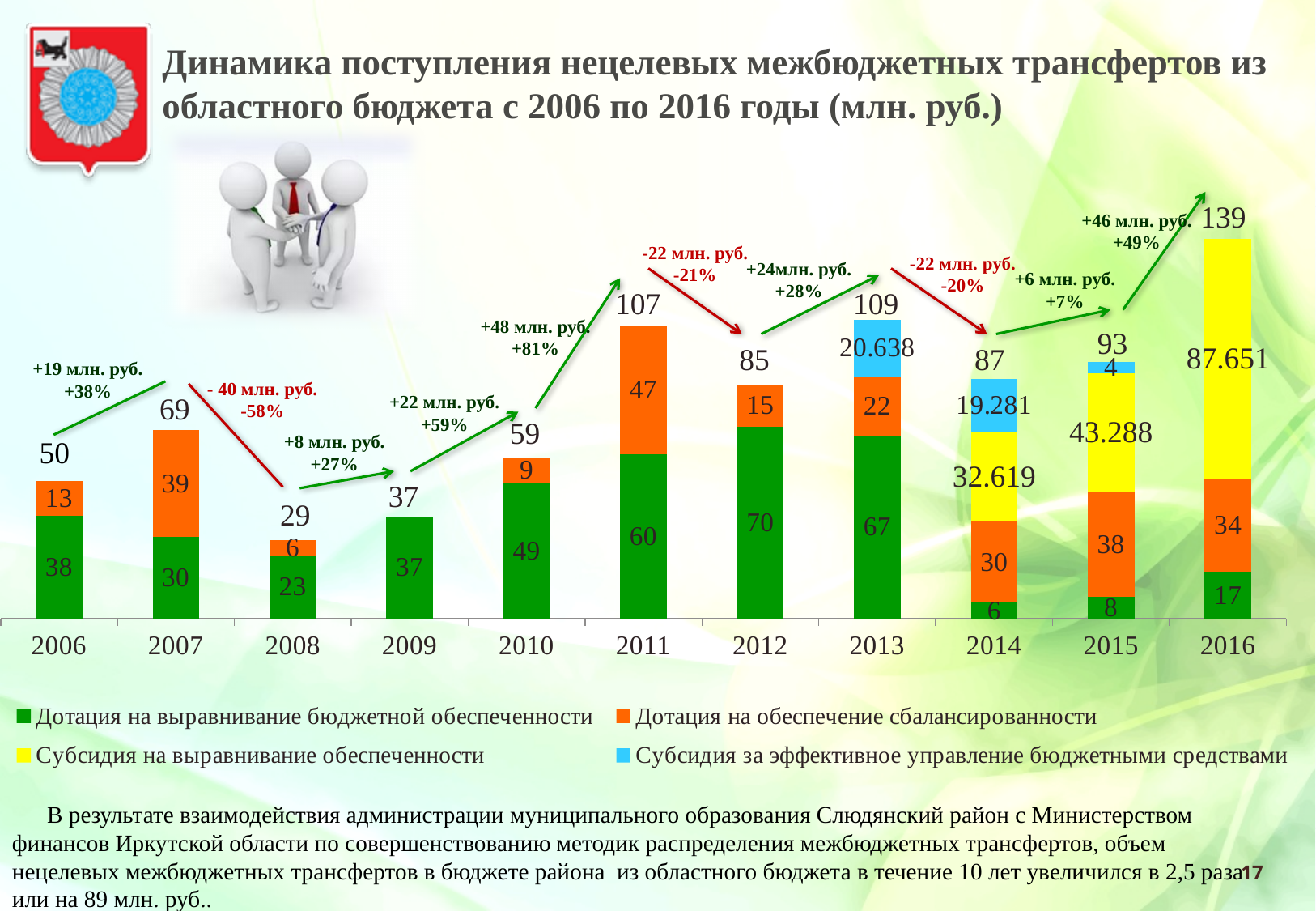
How many series does the chart legend list? 4 Which year has the larger total, 2007 or 2009? 2007 What is the value of "Субсидия на выравнивание обеспеченности" (yellow) for 2015? 43.288 What is the value of "Дотация на обеспечение сбалансированности" (orange) for 2011? 47 What is the value of "Дотация на выравнивание бюджетной обеспеченности" (green) for 2012? 70 What kind of chart is shown on the slide? Stacked bar chart By how much does the total for 2011 exceed the total for 2012? 22 Which year has the highest total of transfers? 2016 What is the total labelled above the bar for 2016? 139 What colour represents "Субсидия за эффективное управление бюджетными средствами" in the legend? Light blue How many years are shown along the x axis of the chart? 11 Which year has the lowest total of transfers? 2008